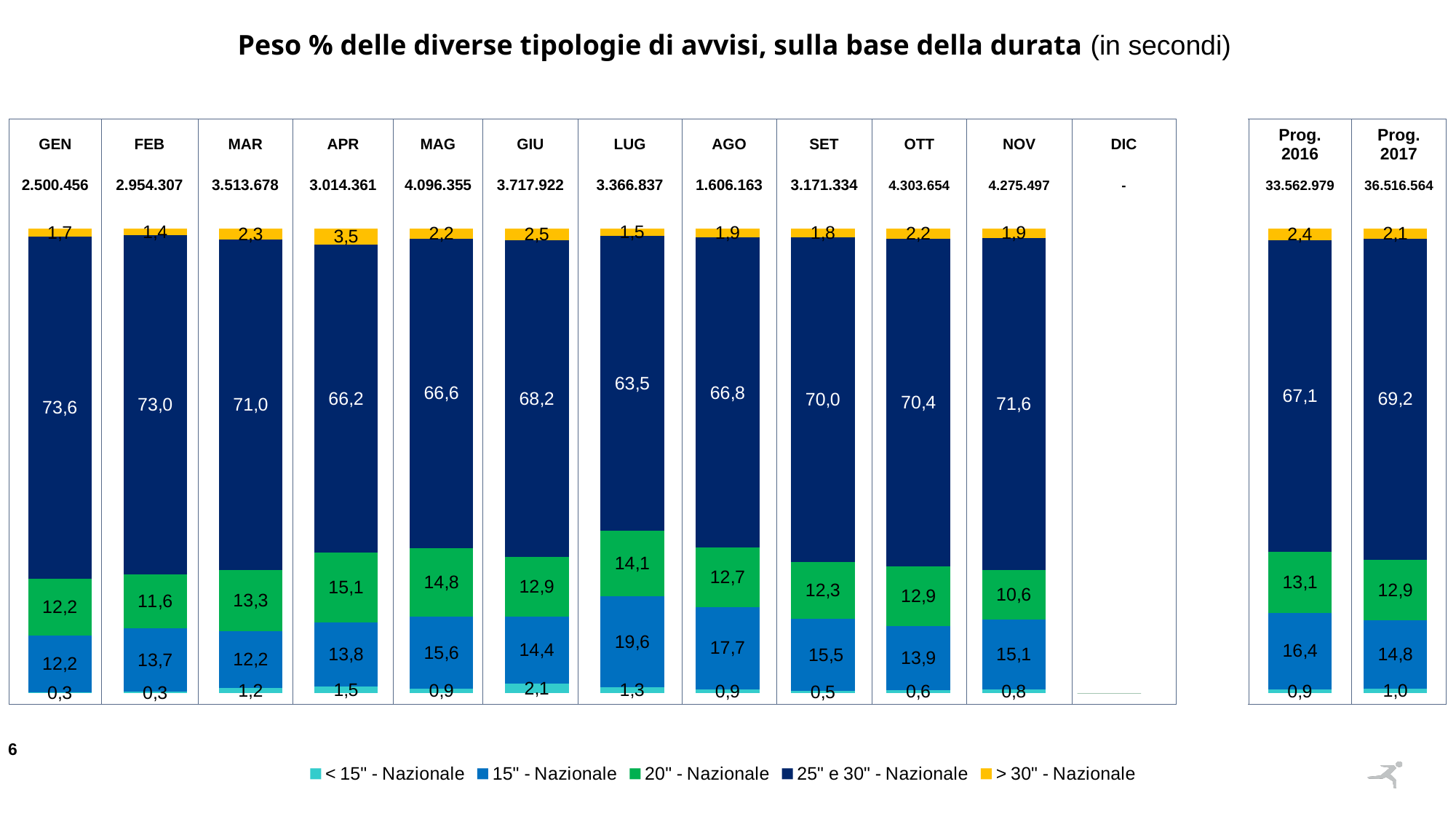
Which month has the highest value for 25" e 30" - Nazionale? GEN What total figure is printed under the GEN column header? 2.500.456 How many months have bars plotted in the chart? 11 Which month has the highest value for > 30" - Nazionale? APR What is the value of the 25" e 30" - Nazionale segment for GEN? 73,6 How many series does the legend list? 5 Which is larger, the 20" - Nazionale value for APR or for MAG? APR Which month has the lowest value for 25" e 30" - Nazionale? LUG What kind of chart is shown on the slide? Stacked bar chart What is the value of the 20" - Nazionale segment for LUG? 14,1 What is the difference between the 15" - Nazionale values for LUG and GEN? 7,4 What is the value of the 15" - Nazionale segment for Prog. 2017? 14,8